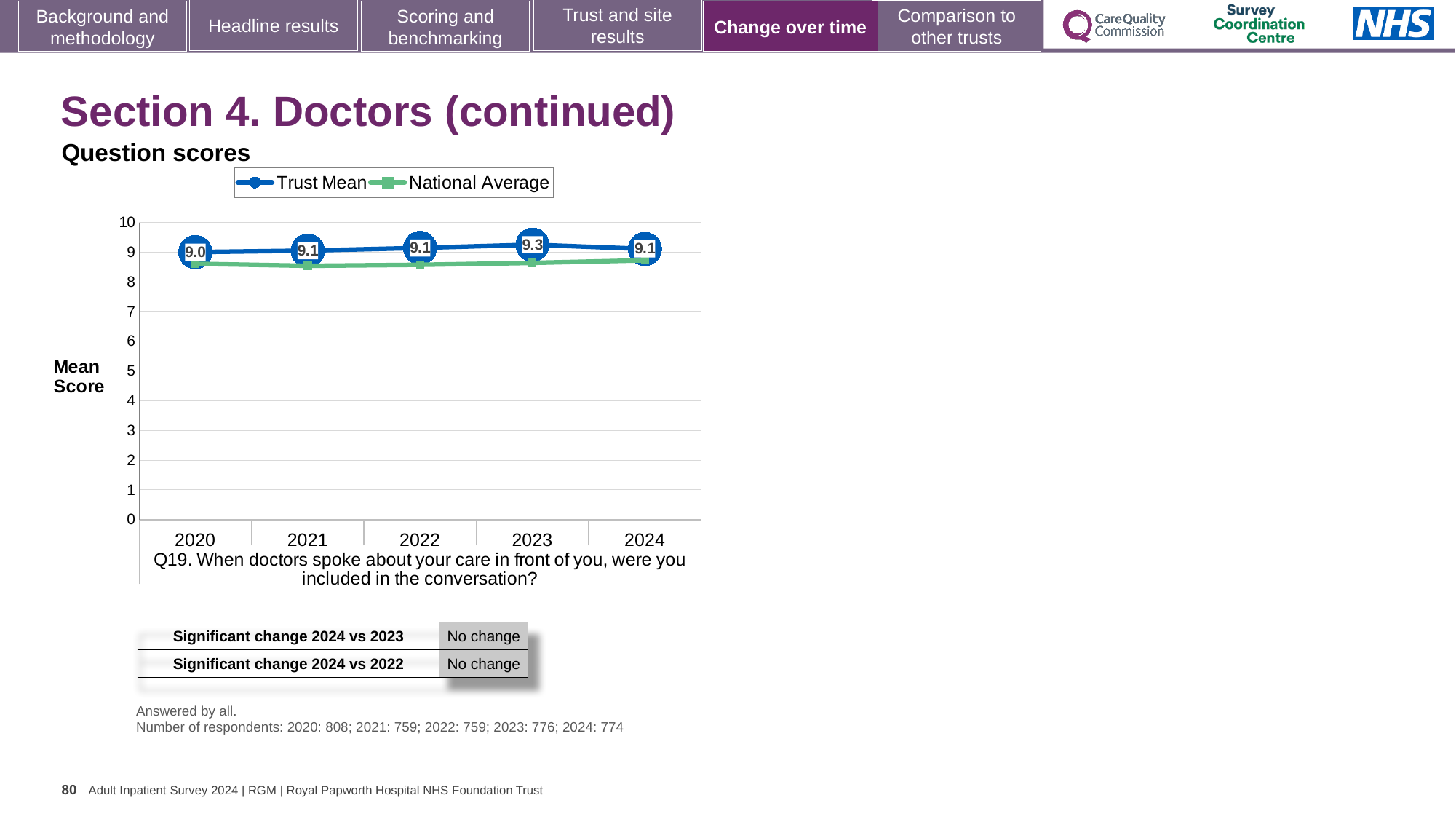
How many series does the legend list? 2 What kind of chart is shown on the slide? Line chart Which is larger, the Trust Mean score in 2023 or in 2024? 2023 What is the Trust Mean score for 2024? 9.1 In which year is the Trust Mean score highest? 2023 Is the National Average value for 2021 greater or less than 9? less In which year is the Trust Mean score lowest? 2020 What is the Trust Mean score for 2023? 9.3 Is the National Average value for 2024 greater or less than 8? greater What is the difference between the Trust Mean score in 2023 and in 2020? 0.3 How many years are plotted on the x axis? 5 What is the Trust Mean score for 2020? 9.0